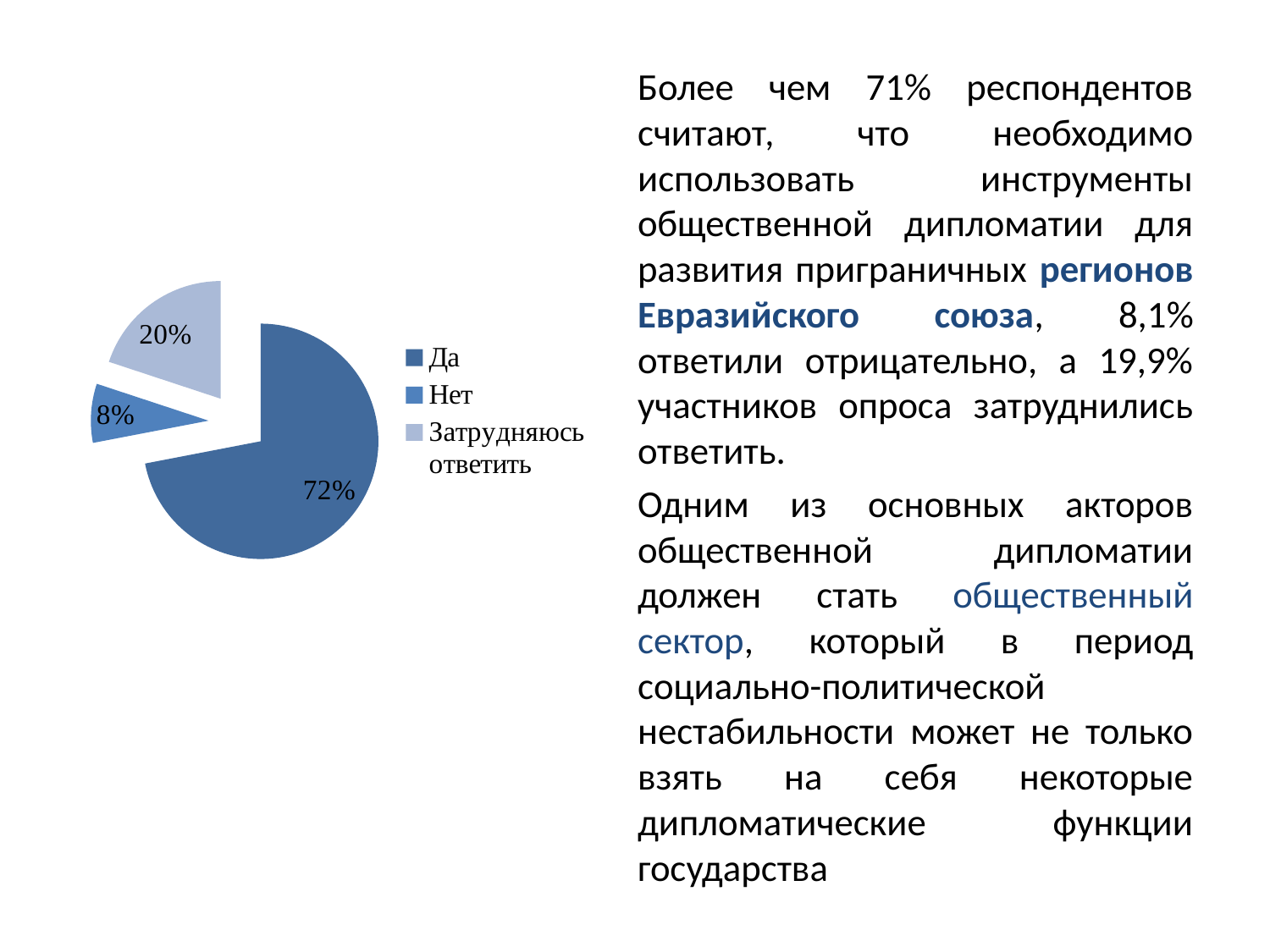
What is the value for the "Нет" slice? 8% What is the value for the "Да" slice? 72% How many slices does the pie chart have? 3 Which category has the largest slice of the pie? Да What share of the pie does the "Да" slice represent? 72% How many entries does the legend list? 3 What is the difference between the "Да" and "Нет" slices? 64% Which category has the smallest slice of the pie? Нет What kind of chart is shown on the slide? pie chart Which is larger, the "Затрудняюсь ответить" slice or the "Нет" slice? Затрудняюсь ответить What is the difference between the "Затрудняюсь ответить" and "Нет" slices? 12% What is the value for the "Затрудняюсь ответить" slice? 20%